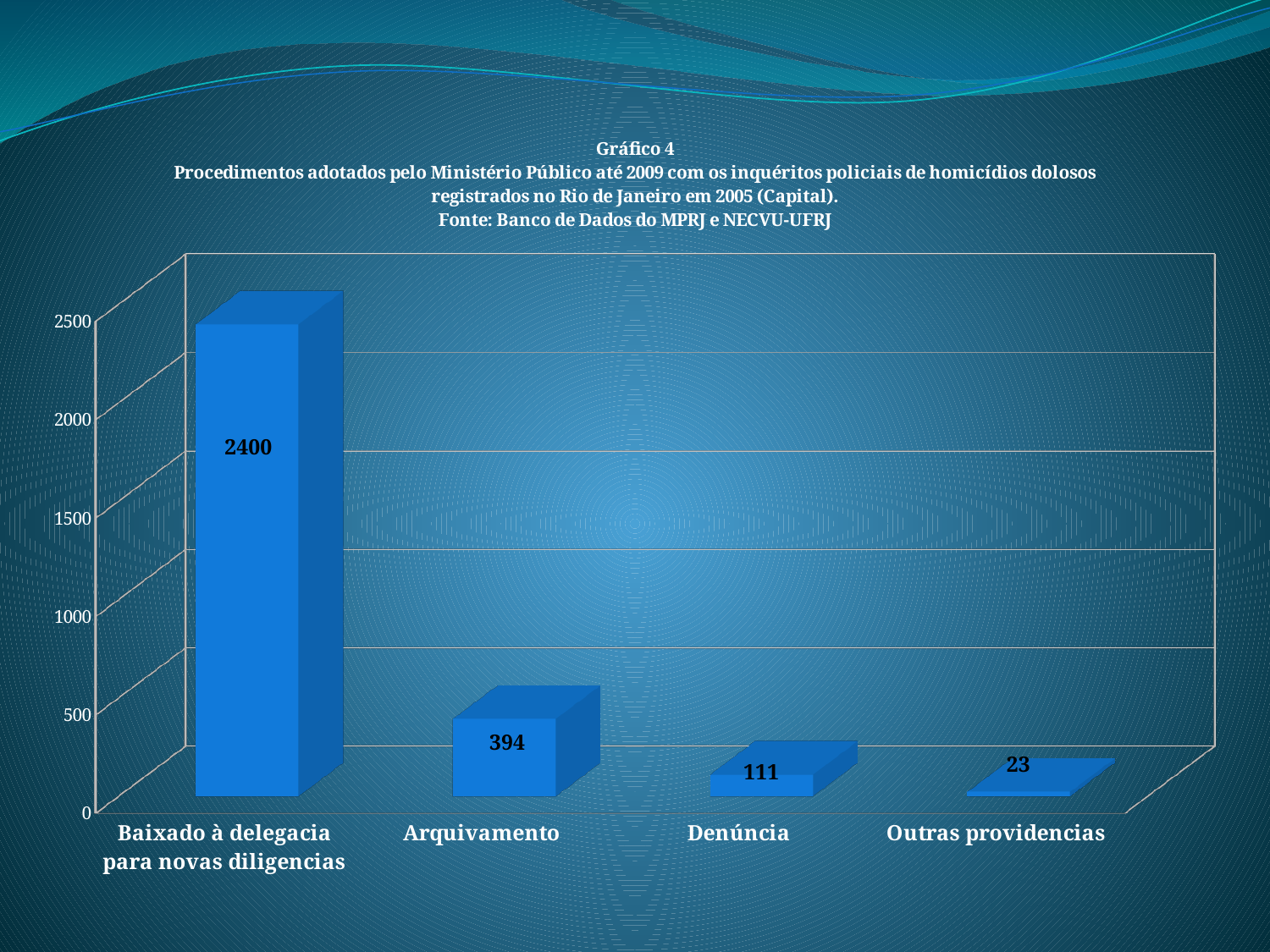
What is the value for Arquivamento? 394 What is the difference between the values for Arquivamento and Denúncia? 283 Which is larger, the value for Denúncia or the value for Outras providencias? Denúncia Which category has the lowest value? Outras providencias What is the value for Baixado à delegacia para novas diligencias? 2400 How many categories are shown in the chart? 4 What is the difference between the values for Baixado à delegacia para novas diligencias and Arquivamento? 2006 Which category has the highest value? Baixado à delegacia para novas diligencias What kind of chart is shown on the slide? bar chart Is the value for Arquivamento greater or less than 500? less What is the value for Denúncia? 111 What is the value for Outras providencias? 23